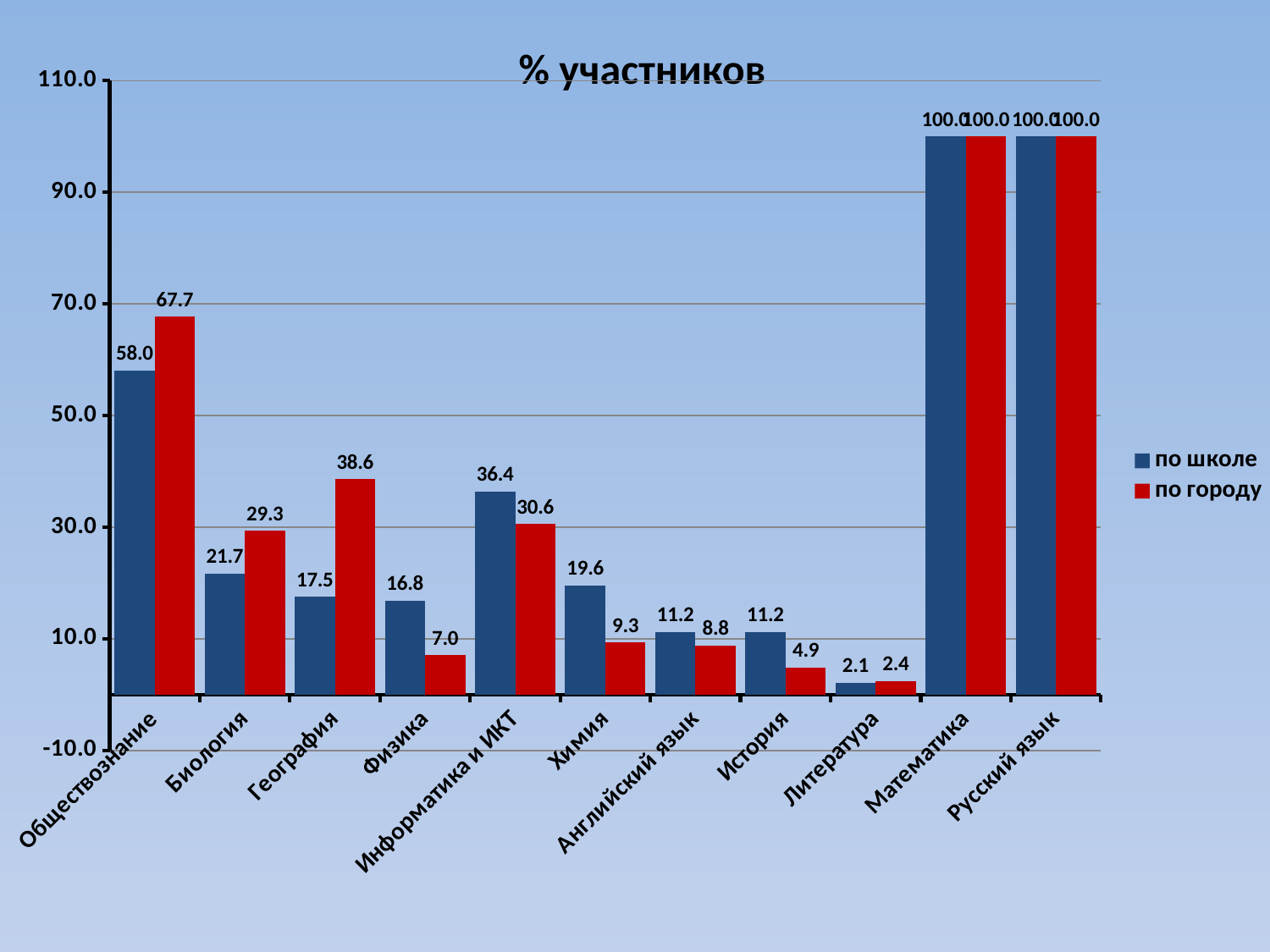
What is the value for Обществознание in the по школе series? 58.0 Which is larger for Информатика и ИКТ: the по школе value or the по городу value? по школе Which category has the lowest value in the по школе series? Литература How many series does the legend list? 2 What is the difference between the по городу and по школе values for Обществознание? 9.7 What is the title of the chart? % участников How many categories are shown on the x axis? 11 What is the value for Химия in the по школе series? 19.6 What is the value for Физика in the по городу series? 7.0 What is the value for География in the по городу series? 38.6 Which is larger for Биология: the по школе value or the по городу value? по городу What kind of chart is shown on the slide? bar chart